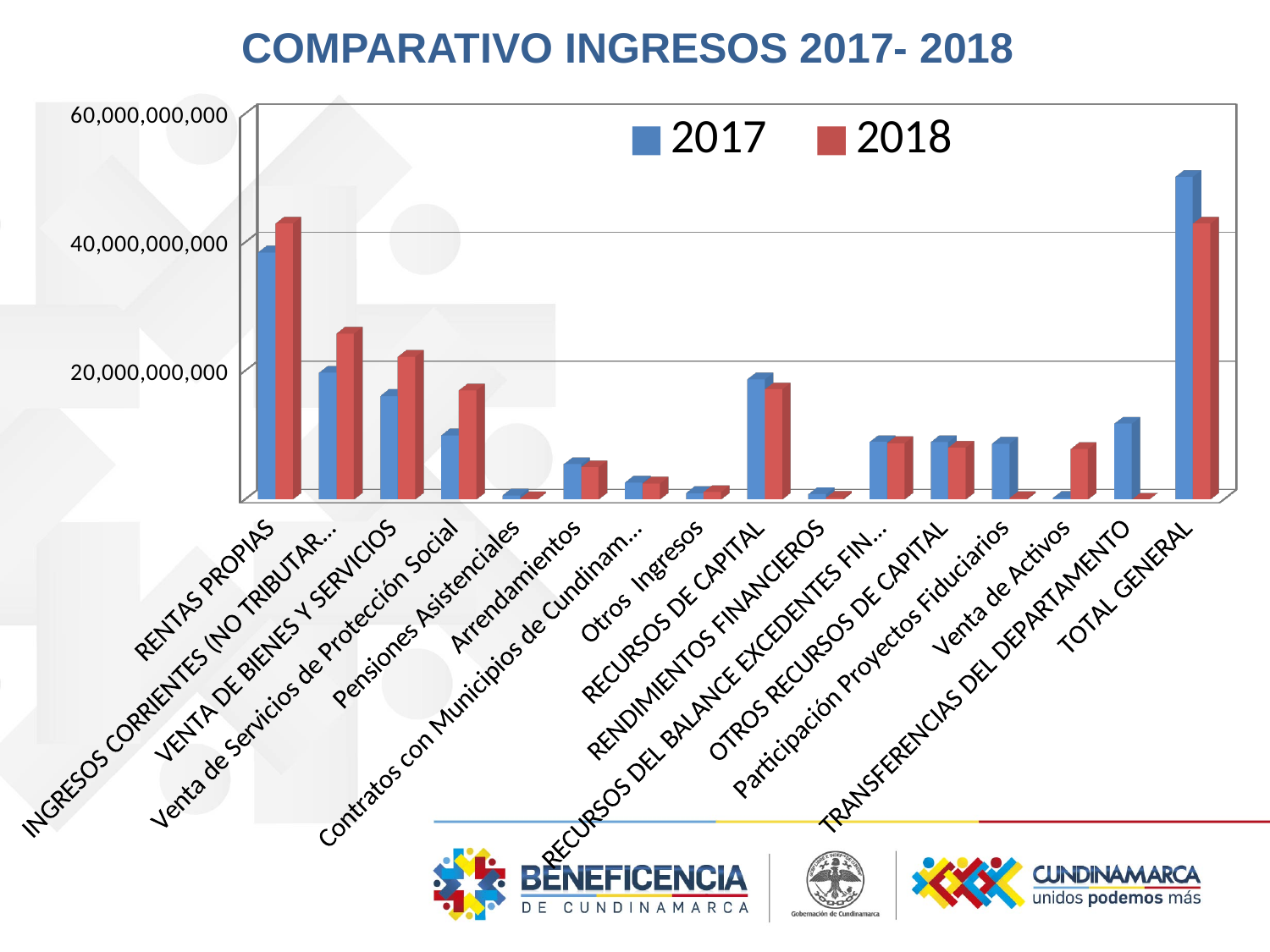
Which category has the highest 2017 value? TOTAL GENERAL Is the 2017 value for TOTAL GENERAL greater or less than 40,000,000,000? greater Is the 2018 value for RENTAS PROPIAS greater or less than 40,000,000,000? greater Is the 2017 value for RENTAS PROPIAS greater or less than 40,000,000,000? less What is the title of the chart? COMPARATIVO INGRESOS 2017- 2018 For RENTAS PROPIAS, which year has the larger value, 2017 or 2018? 2018 What kind of chart is shown on the slide? bar chart How many series does the legend list? 2 How many categories are shown along the x axis? 16 For TRANSFERENCIAS DEL DEPARTAMENTO, which year has the larger value, 2017 or 2018? 2017 For TOTAL GENERAL, which year has the larger value, 2017 or 2018? 2017